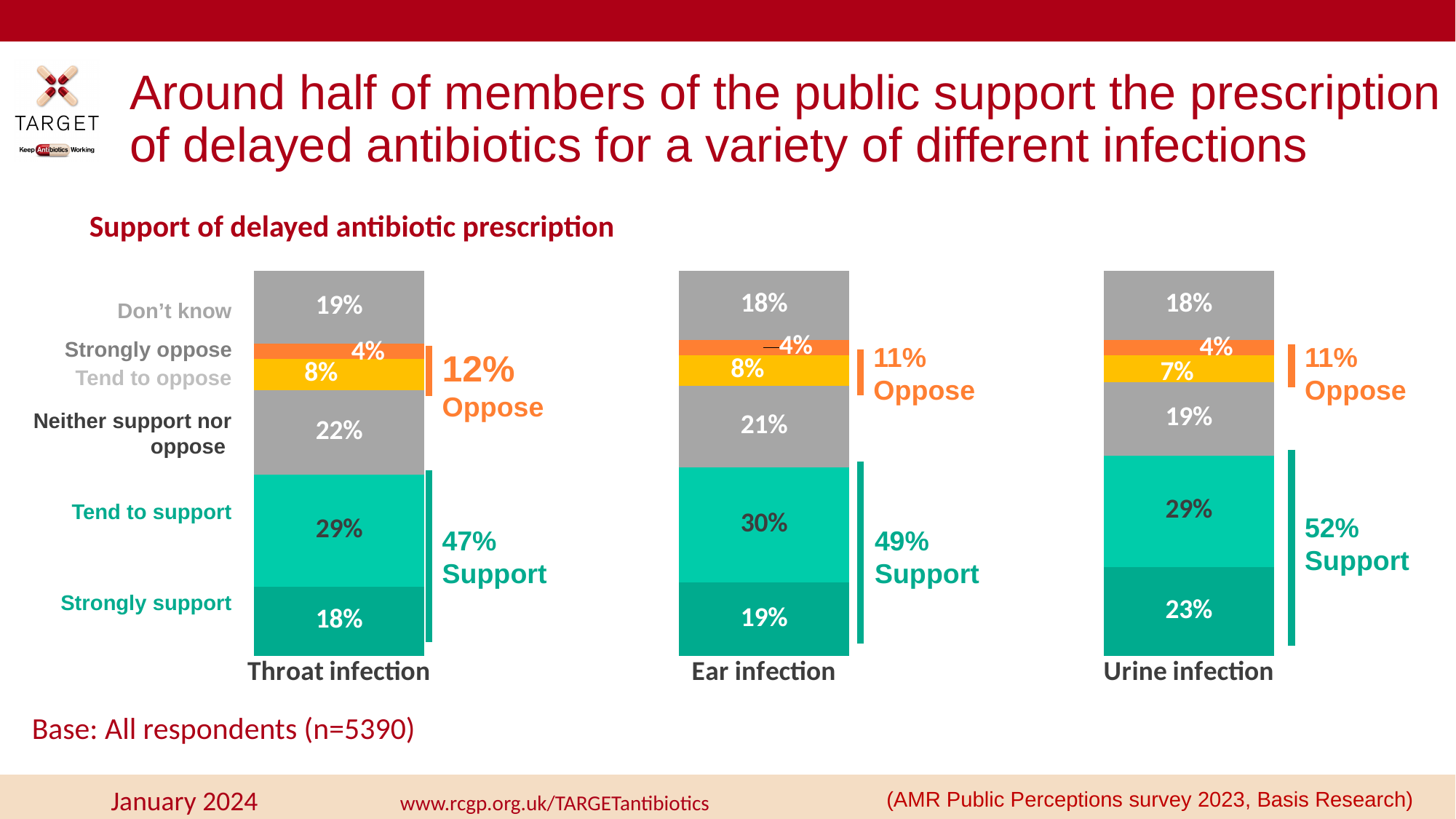
What percentage of respondents strongly support delayed antibiotic prescription for a throat infection? 18% How many infection types are shown as bars in the chart? 3 What percentage of respondents answered 'Don't know' for urine infection? 18% What is the total 'Support' percentage shown for urine infection? 52% Which infection has the lowest total 'Support' percentage? Throat infection Which infection has the highest 'Strongly support' percentage? Urine infection What is the difference between the 'Neither support nor oppose' percentages for throat infection and urine infection? 3% How many response categories are listed on the left of the chart? 6 What type of chart is shown on the slide? Stacked bar chart Is the 'Tend to oppose' percentage higher for throat infection or urine infection? Throat infection What percentage of respondents tend to support delayed antibiotic prescription for an ear infection? 30% What is the total 'Oppose' percentage shown for throat infection? 12%